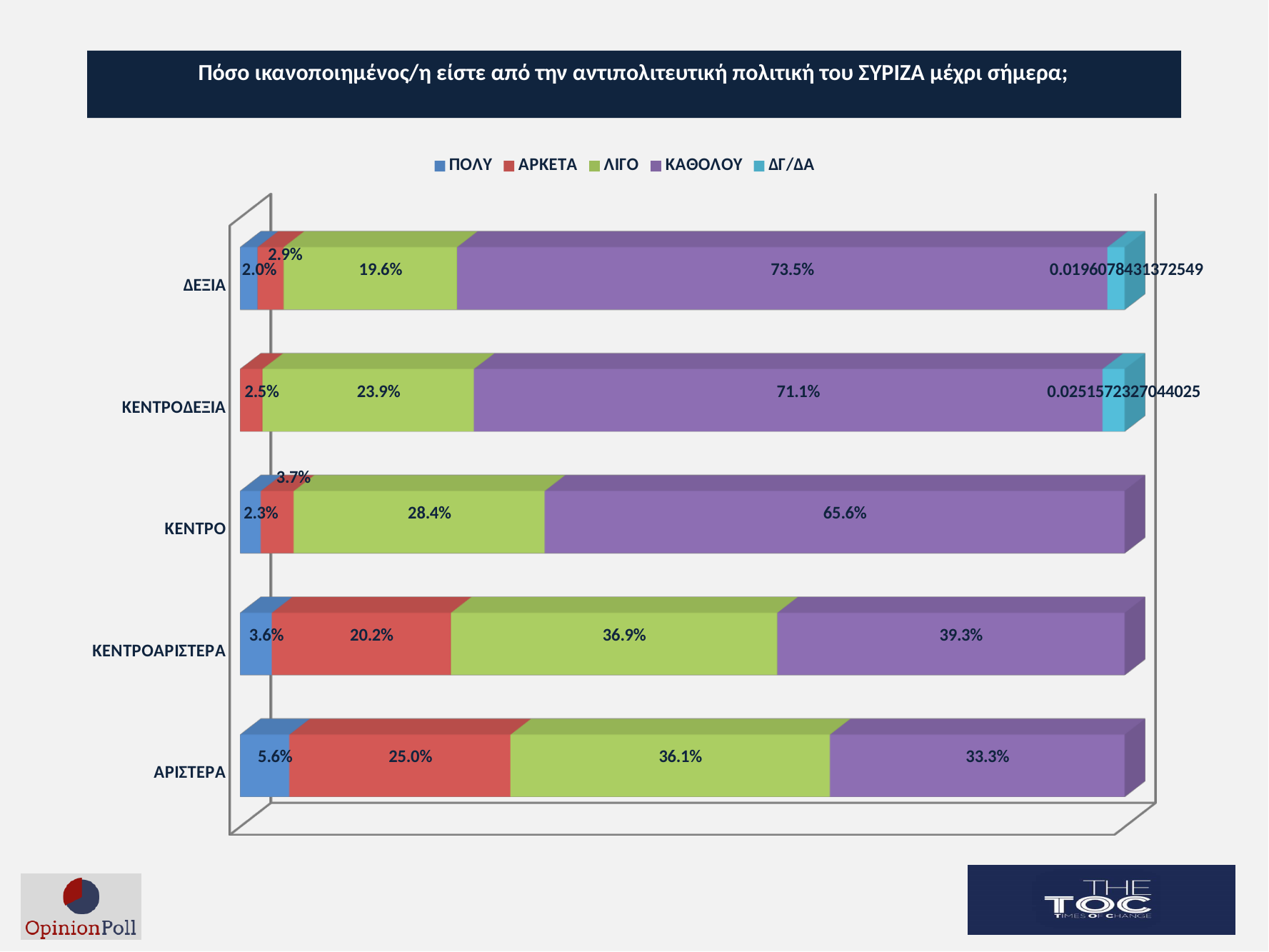
Which category has the lowest ΚΑΘΟΛΟΥ value? ΑΡΙΣΤΕΡΑ What is the ΠΟΛΥ value for ΑΡΙΣΤΕΡΑ? 5.6% Which category has the highest ΚΑΘΟΛΟΥ value? ΔΕΞΙΑ What kind of chart is shown on the slide? Stacked bar chart What is the ΚΑΘΟΛΟΥ value for ΔΕΞΙΑ? 73.5% What is the ΑΡΚΕΤΑ value for ΚΕΝΤΡΟ? 3.7% How many categories are shown on the chart? 5 What is the difference between the ΚΑΘΟΛΟΥ values for ΔΕΞΙΑ and ΑΡΙΣΤΕΡΑ? 40.2 percentage points Which has the larger ΛΙΓΟ value, ΚΕΝΤΡΟ or ΚΕΝΤΡΟΔΕΞΙΑ? ΚΕΝΤΡΟ How many series does the legend list? 5 What is the ΛΙΓΟ value for ΚΕΝΤΡΟΑΡΙΣΤΕΡΑ? 36.9% Which category has the highest ΑΡΚΕΤΑ value? ΑΡΙΣΤΕΡΑ